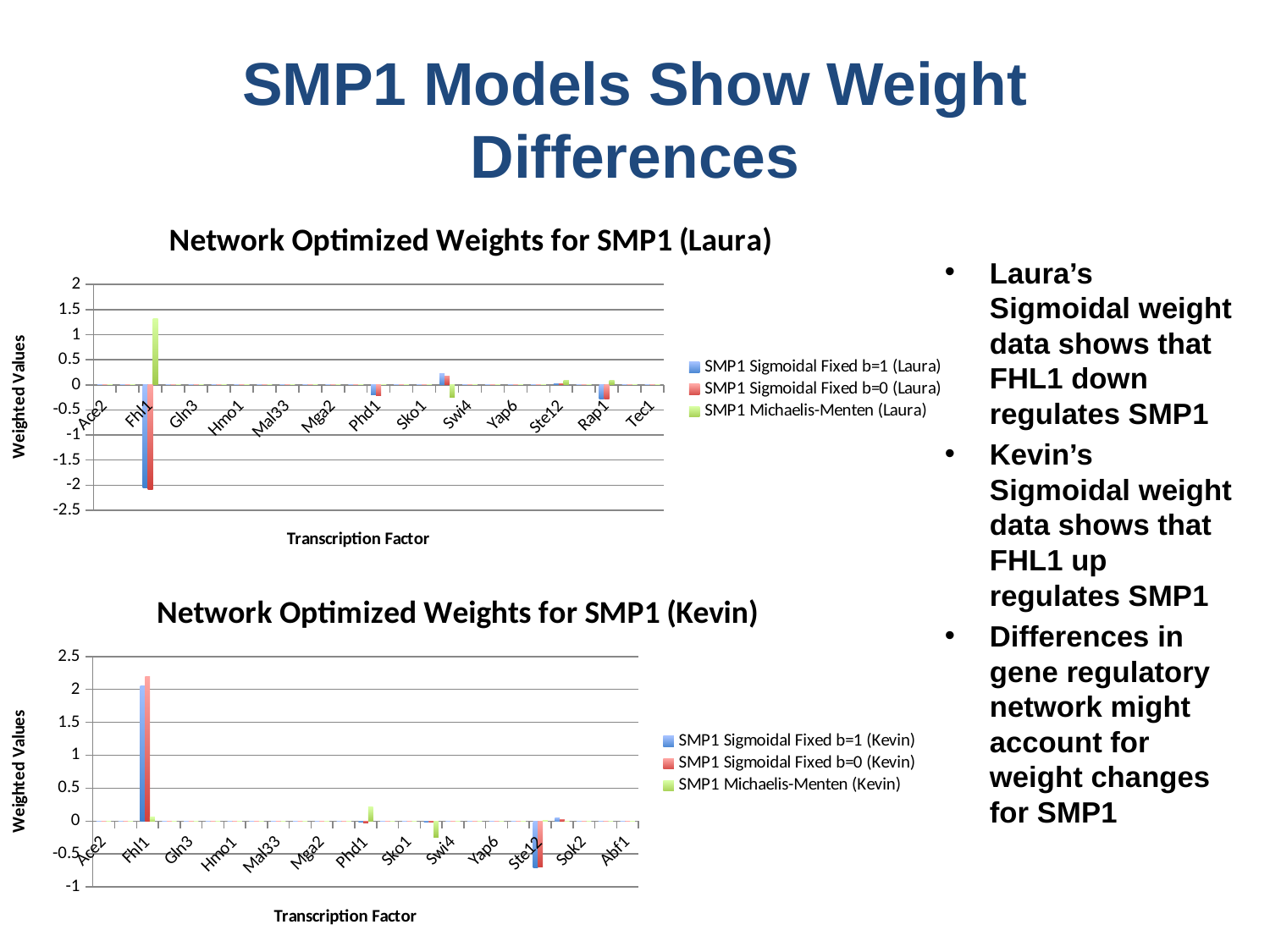
What is the x-axis title of the 'Network Optimized Weights for SMP1 (Laura)' chart? Transcription Factor In the 'Network Optimized Weights for SMP1 (Kevin)' chart, is the value for Fhl1 in the SMP1 Sigmoidal Fixed b=0 (Kevin) series greater or less than 2? greater In the 'Network Optimized Weights for SMP1 (Laura)' chart, is the value for Fhl1 in the SMP1 Sigmoidal Fixed b=1 (Laura) series greater or less than -1? less In the 'Network Optimized Weights for SMP1 (Kevin)' chart, is the value for Ste12 in the SMP1 Sigmoidal Fixed b=0 (Kevin) series greater or less than -0.5? less In the 'Network Optimized Weights for SMP1 (Kevin)' chart, which transcription factor has the highest value for the SMP1 Sigmoidal Fixed b=0 (Kevin) series? Fhl1 How many series does the legend of the 'Network Optimized Weights for SMP1 (Kevin)' chart list? 3 In the 'Network Optimized Weights for SMP1 (Laura)' chart, which transcription factor has the highest value for the SMP1 Michaelis-Menten (Laura) series? Fhl1 In the 'Network Optimized Weights for SMP1 (Kevin)' chart, which transcription factor has the lowest value for the SMP1 Sigmoidal Fixed b=0 (Kevin) series? Ste12 In the 'Network Optimized Weights for SMP1 (Laura)' chart, which transcription factor has the lowest value for the SMP1 Sigmoidal Fixed b=1 (Laura) series? Fhl1 What kind of chart is the 'Network Optimized Weights for SMP1 (Laura)' chart? bar chart In the 'Network Optimized Weights for SMP1 (Kevin)' chart, for Fhl1, which series has the larger value: SMP1 Sigmoidal Fixed b=0 (Kevin) or SMP1 Michaelis-Menten (Kevin)? SMP1 Sigmoidal Fixed b=0 (Kevin)